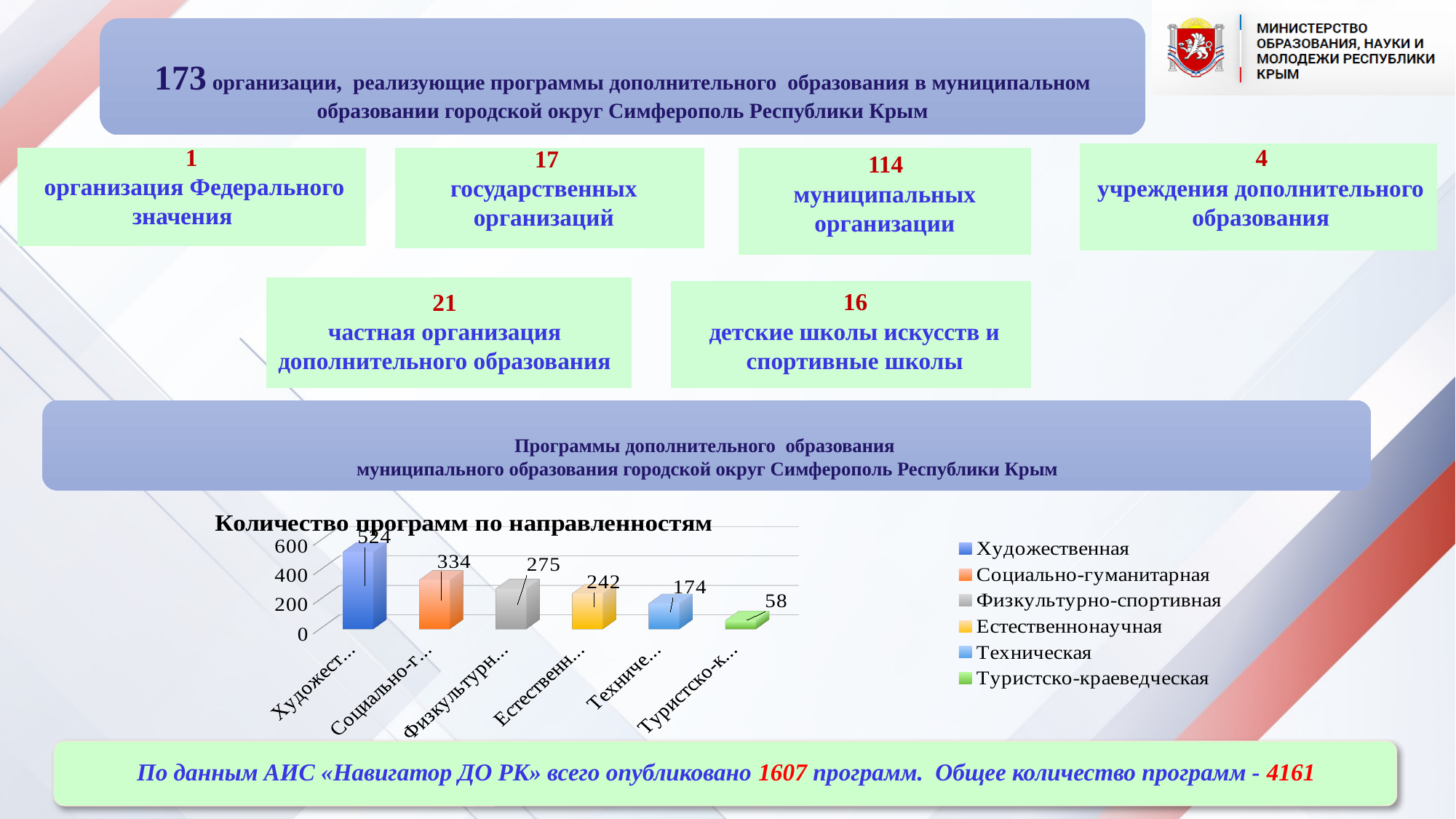
What is the value for Социально-гуманитарная? 334 What type of chart is shown on the slide? bar chart Which category has the highest value? Художественная How many bars are plotted in the chart? 6 What is the difference between the values for Физкультурно-спортивная and Естественнонаучная? 33 Do the values rise or fall from left to right along the x axis? fall How many entries does the chart legend list? 6 Which category has the lowest value? Туристско-краеведческая What is the value for Туристско-краеведческая? 58 What is the value for Художественная? 524 What is the title of the chart on the slide? Количество программ по направленностям Which is larger, the value for Техническая or the value for Естественнонаучная? Естественнонаучная